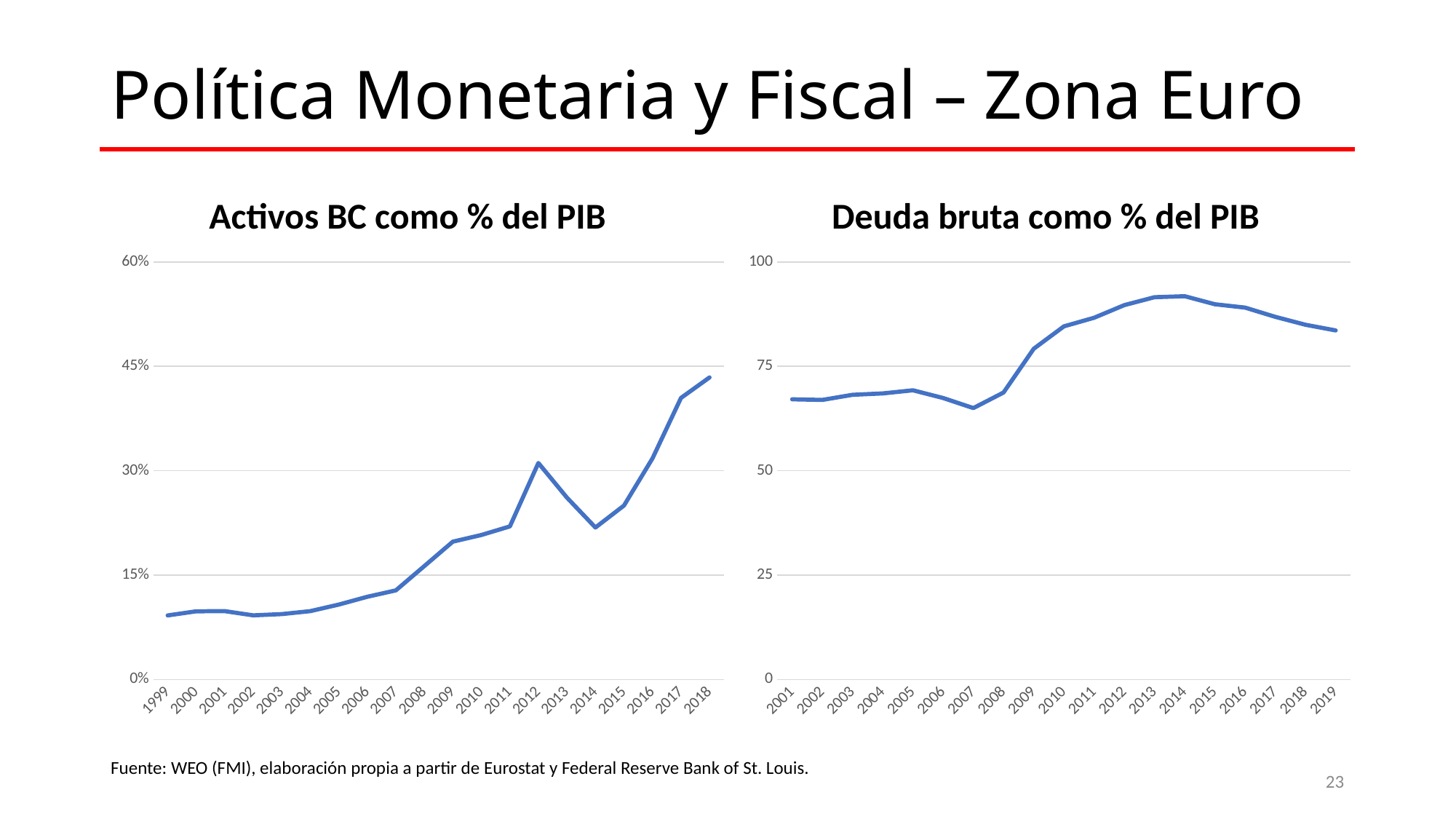
In the "Activos BC como % del PIB" chart, is the value for 2007 greater or less than 15%? less In the "Deuda bruta como % del PIB" chart, do the values rise or fall from 2014 to 2019? fall In the "Activos BC como % del PIB" chart, is the value for 2017 greater or less than 30%? greater In the "Deuda bruta como % del PIB" chart, how many years are shown on the x axis? 19 What kind of chart is "Deuda bruta como % del PIB"? line chart In the "Activos BC como % del PIB" chart, which is larger, the value for 2012 or the value for 2014? 2012 In the "Deuda bruta como % del PIB" chart, which is larger, the value for 2005 or the value for 2009? 2009 In the "Activos BC como % del PIB" chart, which year has the highest value? 2018 What kind of chart is "Activos BC como % del PIB"? line chart In the "Activos BC como % del PIB" chart, how many years are shown on the x axis? 20 In the "Deuda bruta como % del PIB" chart, is the value for 2010 greater or less than 75? greater In the "Deuda bruta como % del PIB" chart, which year has the lowest value? 2007